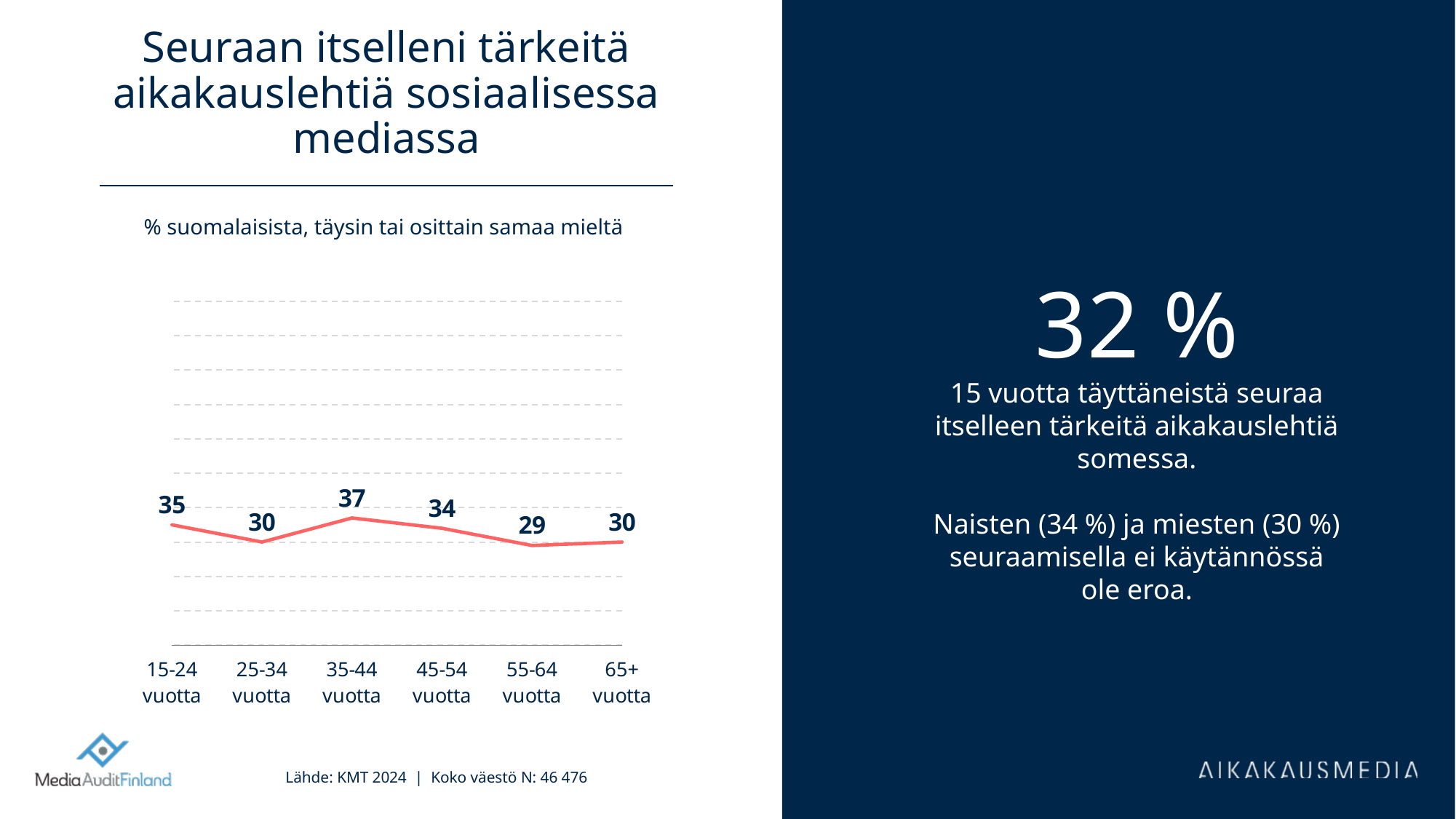
Which is larger, the value for 15-24 vuotta or the value for 45-54 vuotta? 15-24 vuotta What kind of chart is shown on the slide? Line chart What is the difference between the values for 35-44 vuotta and 55-64 vuotta? 8 What is the value for the 55-64 vuotta age group? 29 Which age group has the highest value? 35-44 vuotta What is the value for the 65+ vuotta age group? 30 What is the value for the 35-44 vuotta age group? 37 How many age groups are shown on the x axis? 6 What is the value for the 15-24 vuotta age group? 35 Which age group has the lowest value? 55-64 vuotta What is the subtitle shown above the chart? % suomalaisista, täysin tai osittain samaa mieltä Does the value rise or fall from 35-44 vuotta to 55-64 vuotta? Fall